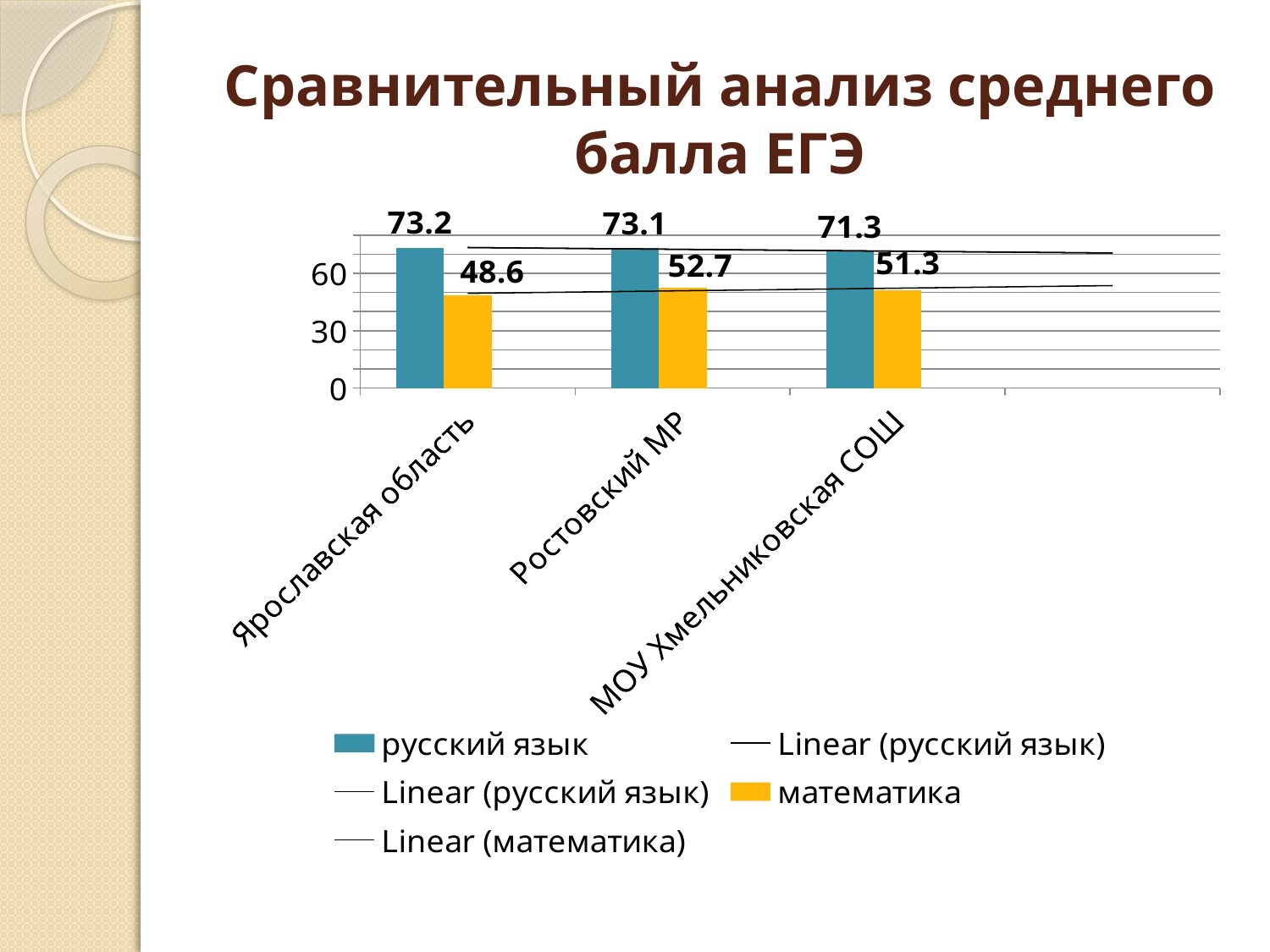
What is the value for математика in Ростовский МР? 52.7 Which category has the lowest value for математика? Ярославская область What kind of chart is shown on the slide? bar chart Which is larger in Ростовский МР: the value for русский язык or for математика? русский язык Which category has the highest value for математика? Ростовский МР How many entries does the legend list? 5 What is the value for русский язык in МОУ Хмельниковская СОШ? 71.3 What is the value for математика in МОУ Хмельниковская СОШ? 51.3 What is the value for русский язык in Ярославская область? 73.2 What is the difference between the математика values for Ростовский МР and Ярославская область? 4.1 What is the difference between the русский язык and математика values in Ярославская область? 24.6 How many categories are shown on the x axis? 3